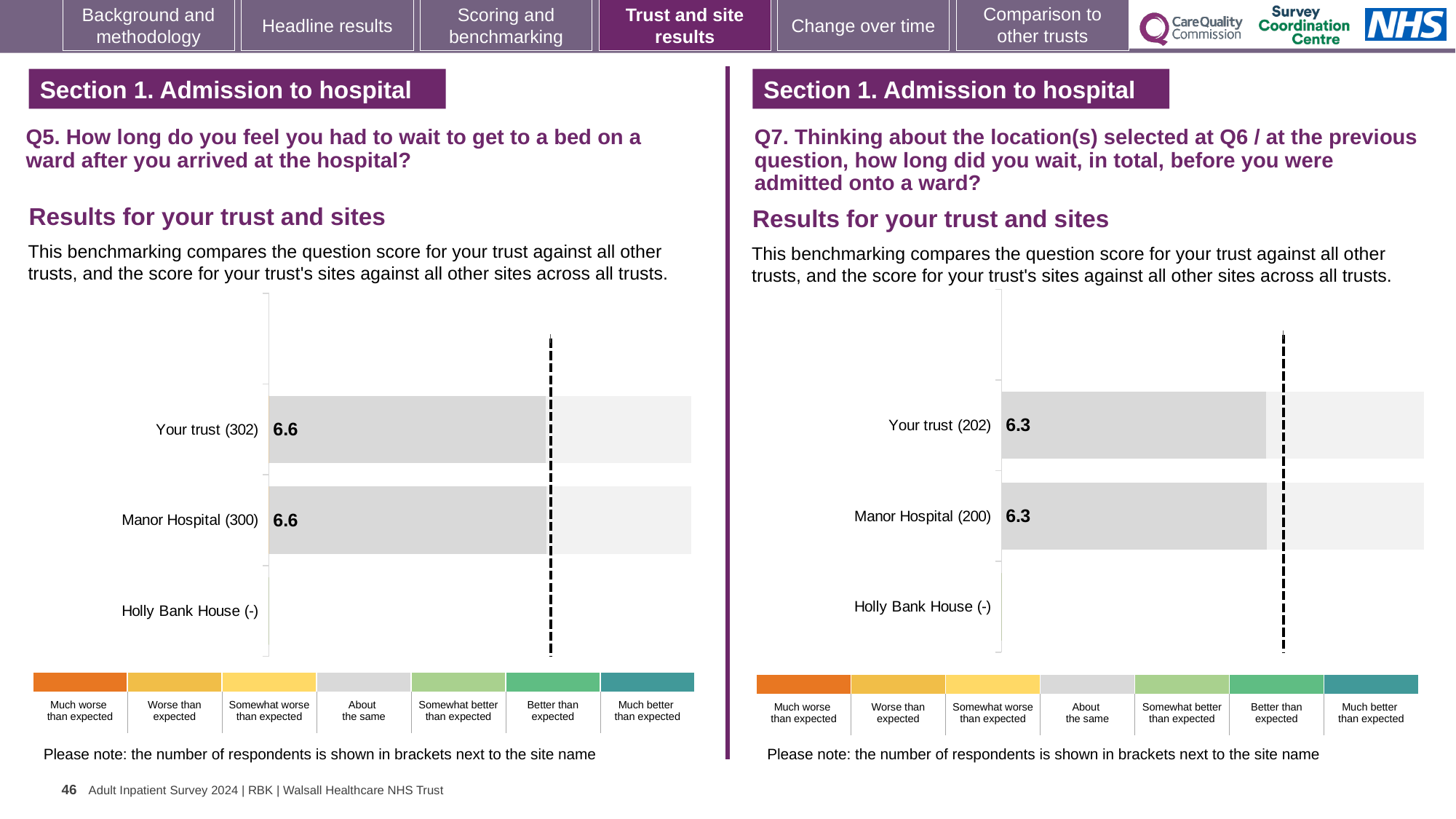
In the Q7 chart on the right, which category has no score shown? Holly Bank House (-) How many categories are listed on the y axis of the Q5 chart on the left? 3 In the Q7 chart on the right, what is the difference between the scores for Your trust and Manor Hospital? 0 In the Q7 chart on the right, what is the score for Manor Hospital (200)? 6.3 What kind of chart is the Q5 chart on the left? Bar chart How many respondents are shown in brackets for Your trust in the Q5 chart on the left? 302 In the Q5 chart on the left, what is the difference between the scores for Your trust and Manor Hospital? 0 In the Q5 chart on the left, what is the score for Manor Hospital (300)? 6.6 How many categories are listed on the y axis of the Q7 chart on the right? 3 In the Q7 chart on the right, what is the score for Your trust (202)? 6.3 In the Q5 chart on the left, what is the score for Your trust (302)? 6.6